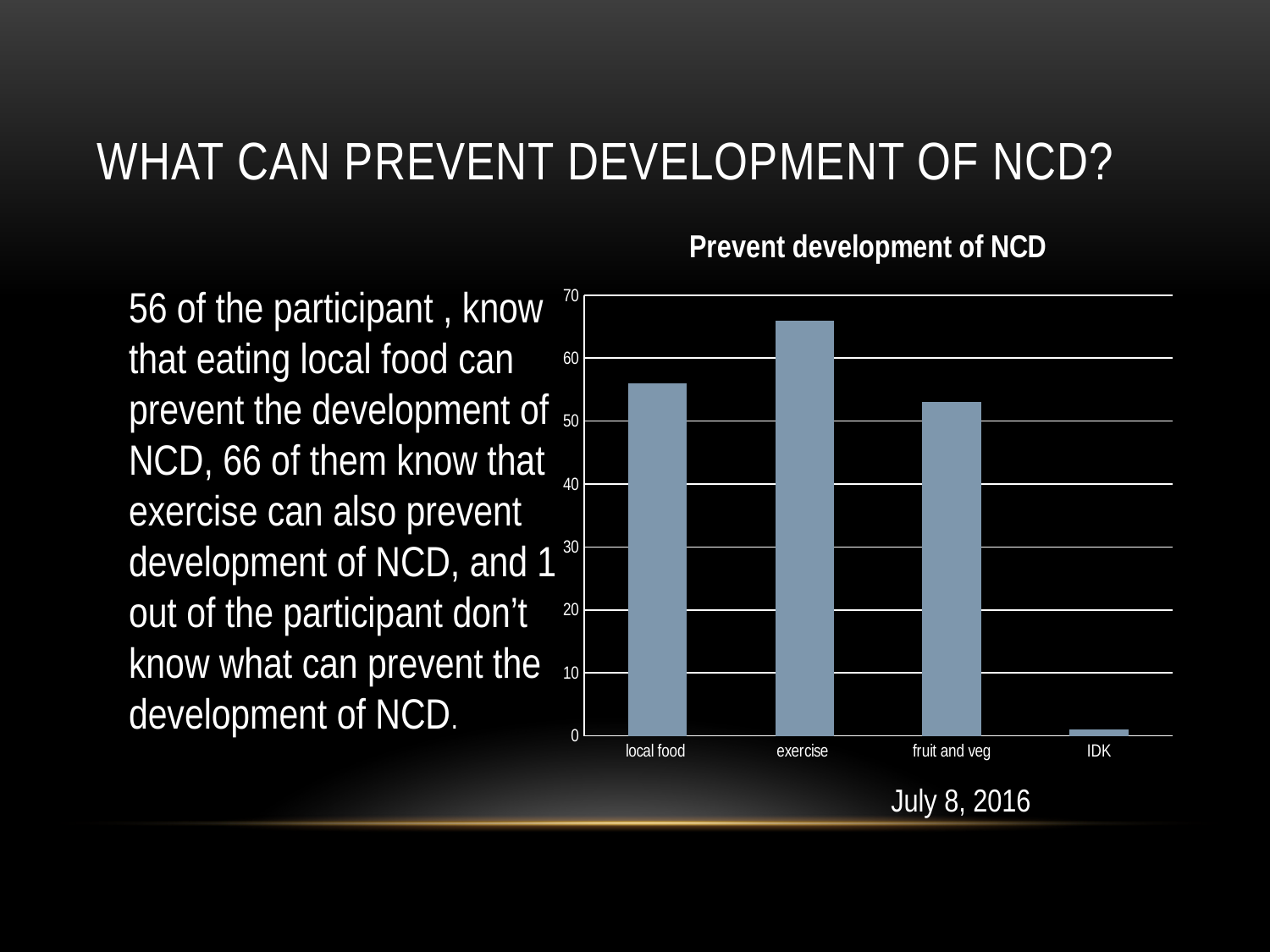
Which category has the lowest bar in the chart? IDK Is the value for fruit and veg greater or less than 60? less How many categories are shown on the x axis of the chart? 4 What is the highest value shown on the chart's vertical axis? 70 What kind of chart is shown on the slide? bar chart Which is larger, the value for fruit and veg or the value for IDK? fruit and veg Is the value for exercise greater or less than 60? greater Which is larger, the value for exercise or the value for local food? exercise Which category has the highest bar in the chart? exercise What is the title of the chart? Prevent development of NCD Is the value for IDK greater or less than 10? less